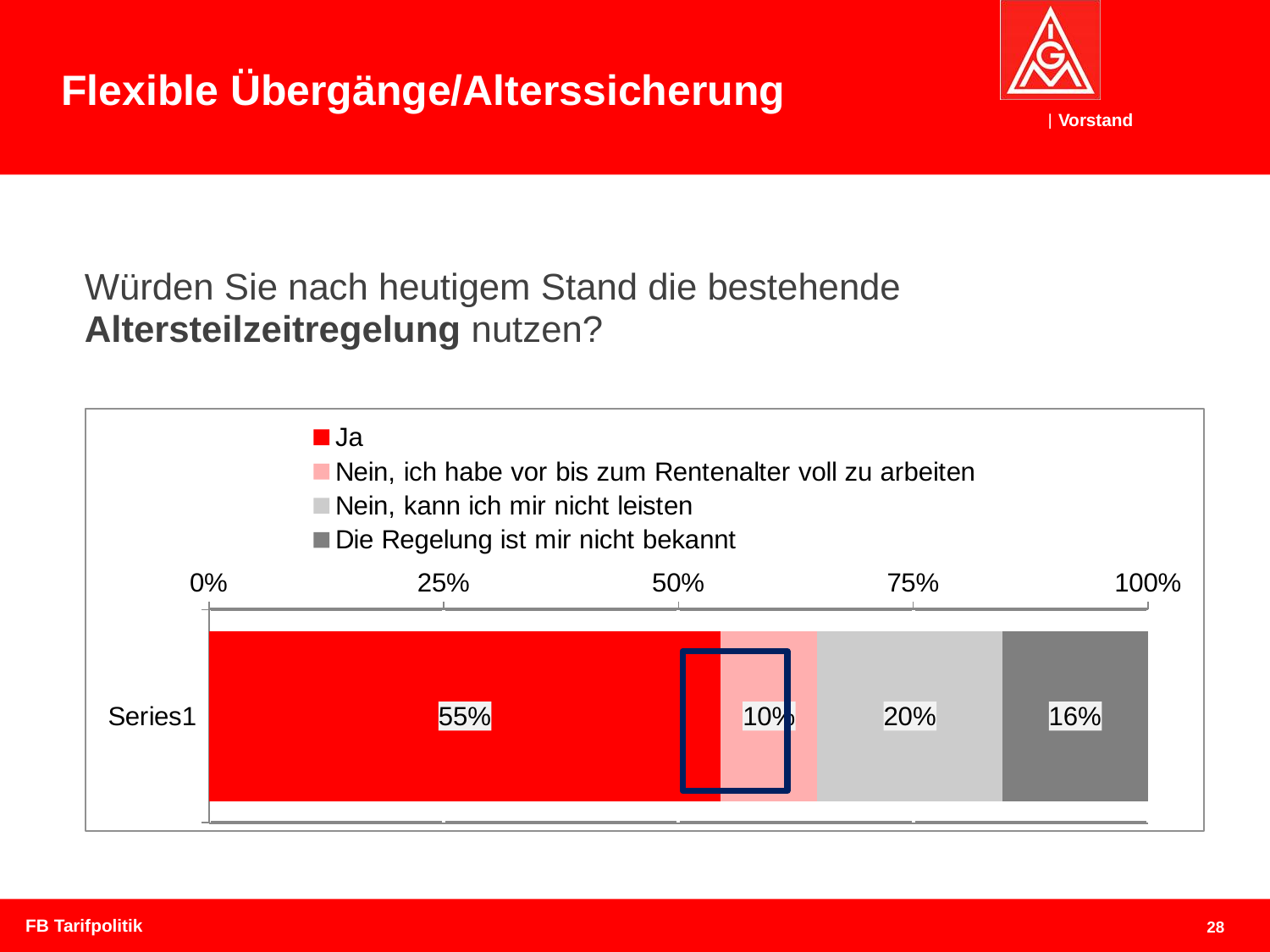
What is the value for "Nein, ich habe vor bis zum Rentenalter voll zu arbeiten"? 10% Which response has the largest share in the bar? Ja What is the value for "Die Regelung ist mir nicht bekannt"? 16% Is the value for "Ja" greater or less than 50%? greater Which response has the smallest share in the bar? Nein, ich habe vor bis zum Rentenalter voll zu arbeiten Which is larger: "Nein, kann ich mir nicht leisten" or "Die Regelung ist mir nicht bekannt"? Nein, kann ich mir nicht leisten Which legend entry is shown in dark grey? Die Regelung ist mir nicht bekannt How many series does the legend list? 4 What is the difference between the "Ja" share and the "Nein, kann ich mir nicht leisten" share? 35% What percentage of respondents answered "Ja"? 55% What kind of chart is shown on the slide? Stacked bar chart What is the value for "Nein, kann ich mir nicht leisten"? 20%